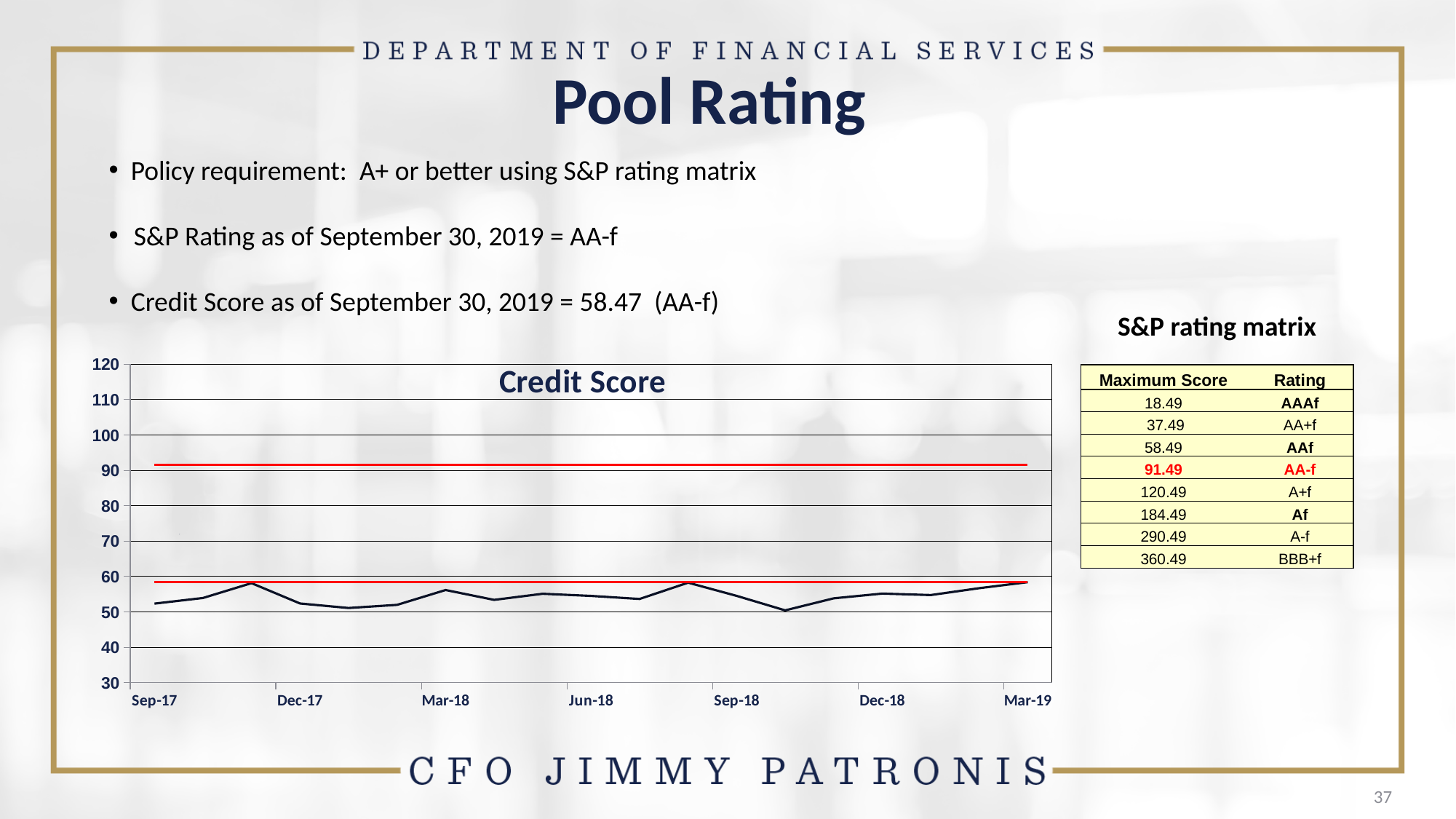
What is the first date label on the x axis of the Credit Score chart? Sep-17 What type of chart is the Credit Score chart? Line chart Is the credit score value for Dec-18 greater or less than 70? less Is the credit score value for Mar-18 greater or less than 50? greater Is the credit score value for Jun-18 greater or less than 60? less What is the last date label on the x axis of the Credit Score chart? Mar-19 What is the highest value shown on the y axis of the Credit Score chart? 120 How many date labels are shown on the x axis of the Credit Score chart? 7 What is the title of the chart on the slide? Credit Score